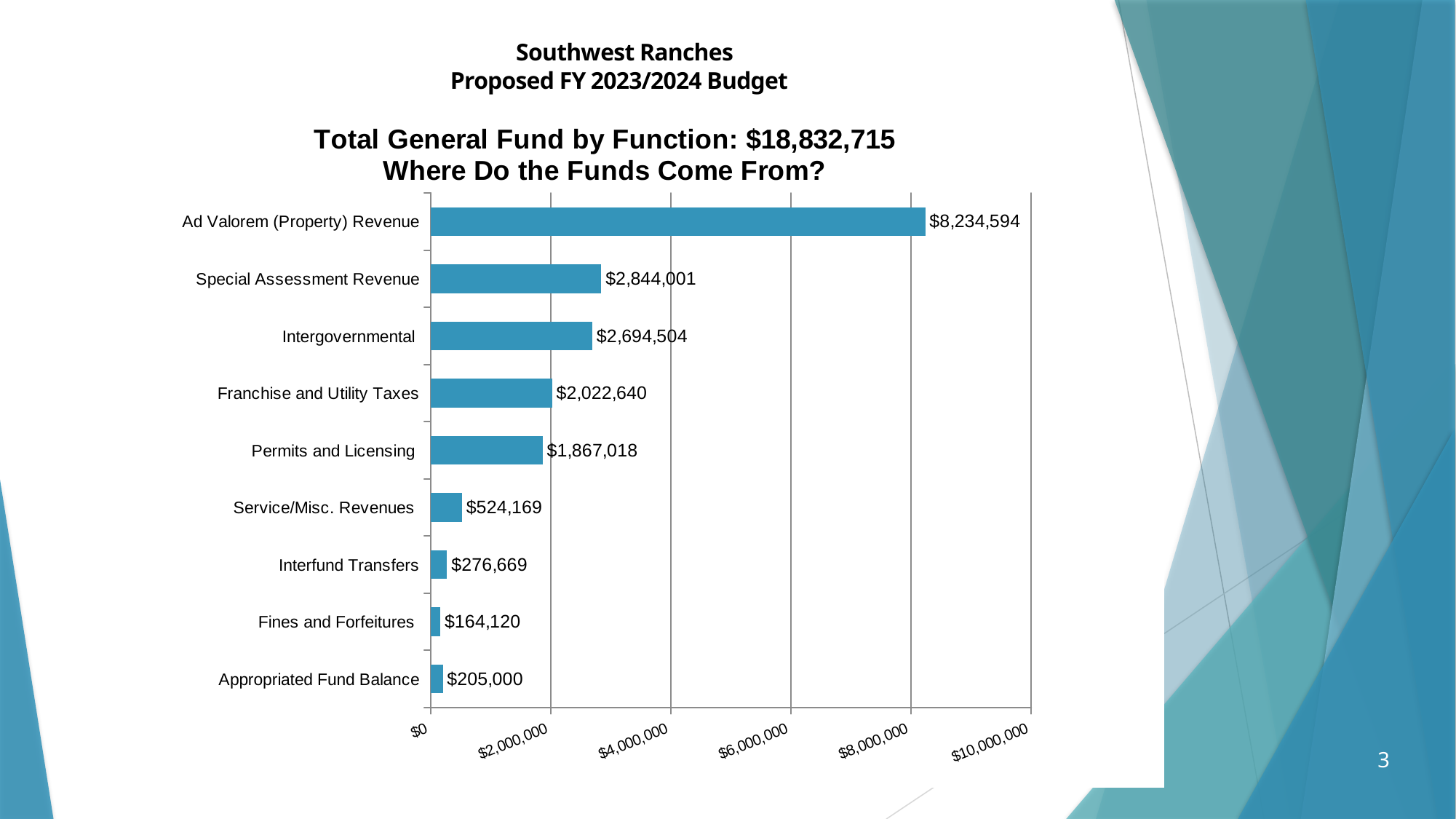
What total General Fund amount is stated in the chart title? $18,832,715 What is the difference between Franchise and Utility Taxes and Permits and Licensing? $155,622 What is the difference between Special Assessment Revenue and Intergovernmental? $149,497 Which is larger, Appropriated Fund Balance or Fines and Forfeitures? Appropriated Fund Balance Is the value for Ad Valorem (Property) Revenue greater or less than $8,000,000? greater How many categories are shown in the chart? 9 What is the value for Fines and Forfeitures? $164,120 Which category has the lowest value? Fines and Forfeitures What is the value for Ad Valorem (Property) Revenue? $8,234,594 Which category has the highest value? Ad Valorem (Property) Revenue What kind of chart is shown on the slide? bar chart What is the value for Intergovernmental? $2,694,504